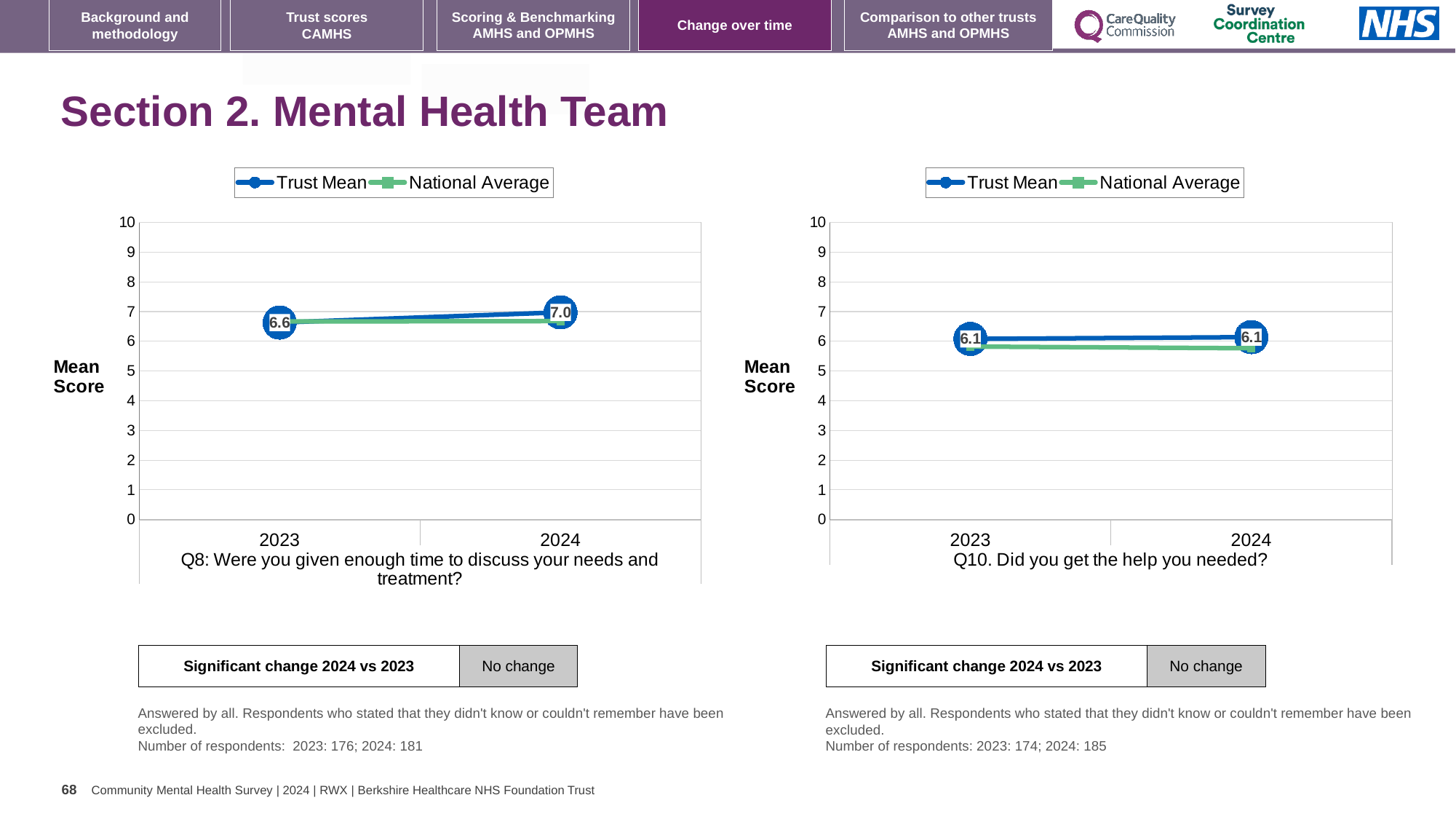
How many years are plotted on the x axis of the left chart (Q8)? 2 In the right chart (Q10), what is the Trust Mean score for 2023? 6.1 In the left chart (Q8), what is the Trust Mean score for 2023? 6.6 In the right chart (Q10), what is the Trust Mean score for 2024? 6.1 What kind of chart is the right chart (Q10)? line chart How many series does the legend of the left chart (Q8) list? 2 In the left chart (Q8), which year has the higher Trust Mean score, 2023 or 2024? 2024 In the left chart (Q8), what is the Trust Mean score for 2024? 7.0 In the right chart (Q10), does the Trust Mean rise, fall or stay the same from 2023 to 2024? stay the same In the right chart (Q10), is the National Average value for 2024 greater or less than 5? greater In the left chart (Q8), what is the difference between the Trust Mean scores for 2024 and 2023? 0.4 In the left chart (Q8), does the Trust Mean rise or fall from 2023 to 2024? rise